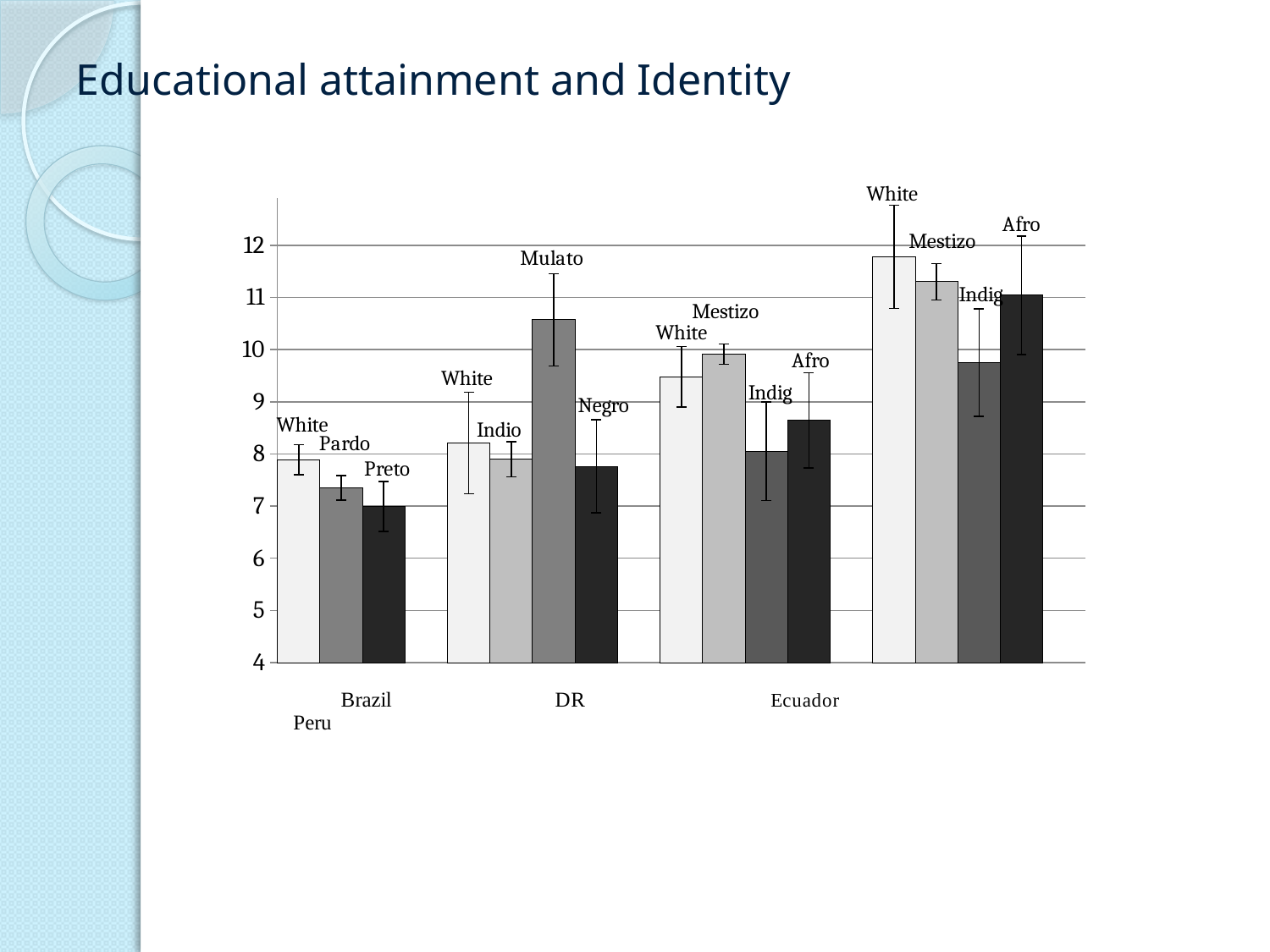
Within the Peru group, which identity has the highest bar? White Is the value for Mestizo in Peru greater or less than 11? greater How many bars are shown for Brazil? 3 Which bar is the lowest in the whole chart? Preto in Brazil What is the title of the slide containing the chart? Educational attainment and Identity How many countries are shown along the x axis of the chart? 4 Which bar is the tallest in the whole chart? White in Peru Is the value for Preto in Brazil greater or less than 8? less In the Ecuador group, which is larger, the White bar or the Mestizo bar? Mestizo What kind of chart is shown on the slide? bar chart Within the Ecuador group, which identity has the lowest bar? Indig Is the value for Mulato in DR greater or less than 10? greater